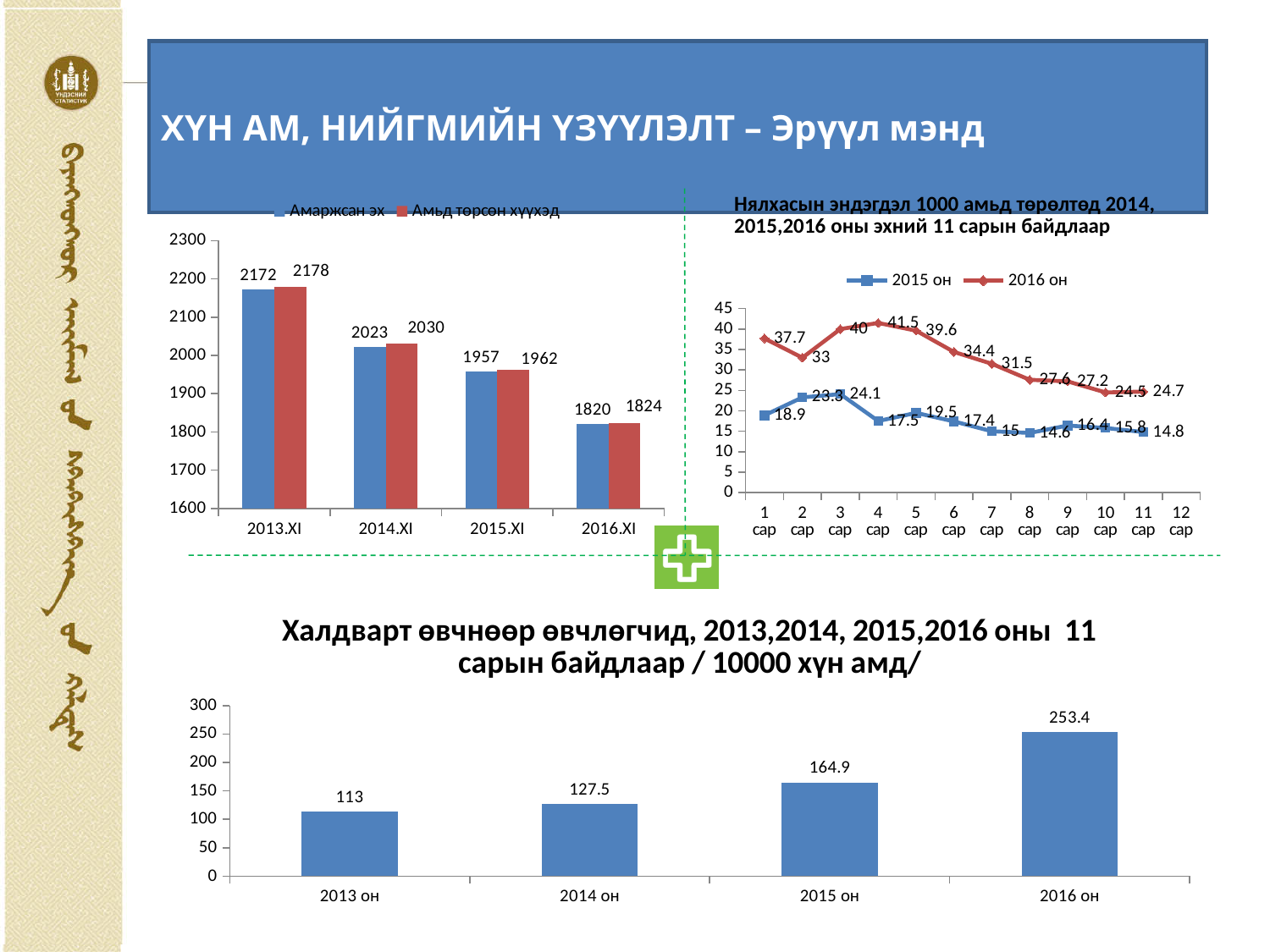
In the top-left bar chart, do the values of Амаржсан эх rise or fall from 2013.XI to 2016.XI? fall In the chart titled 'Нялхасын эндэгдэл 1000 амьд төрөлтөд', which series has the larger value in month 7 (7 сар), 2015 он or 2016 он? 2016 он In the bottom chart titled 'Халдварт өвчнөөр өвчлөгчид', what is the value for 2015 он? 164.9 In the top-left bar chart, what is the value of Амьд төрсөн хүүхэд for 2016.XI? 1824 In the chart titled 'Нялхасын эндэгдэл 1000 амьд төрөлтөд', which month has the highest value for 2016 он? 4 сар In the bottom chart titled 'Халдварт өвчнөөр өвчлөгчид', which year has the highest value? 2016 он What kind of chart is the chart titled 'Нялхасын эндэгдэл 1000 амьд төрөлтөд'? line chart In the chart titled 'Нялхасын эндэгдэл 1000 амьд төрөлтөд', what is the value for 2016 он in month 4 (4 сар)? 41.5 In the top-left bar chart, what is the difference between Амьд төрсөн хүүхэд and Амаржсан эх for 2014.XI? 7 In the chart titled 'Нялхасын эндэгдэл 1000 амьд төрөлтөд', what is the value for 2015 он in month 1 (1 сар)? 18.9 In the top-left bar chart, what is the value of Амаржсан эх for 2013.XI? 2172 How many series does the legend of the top-left bar chart list? 2